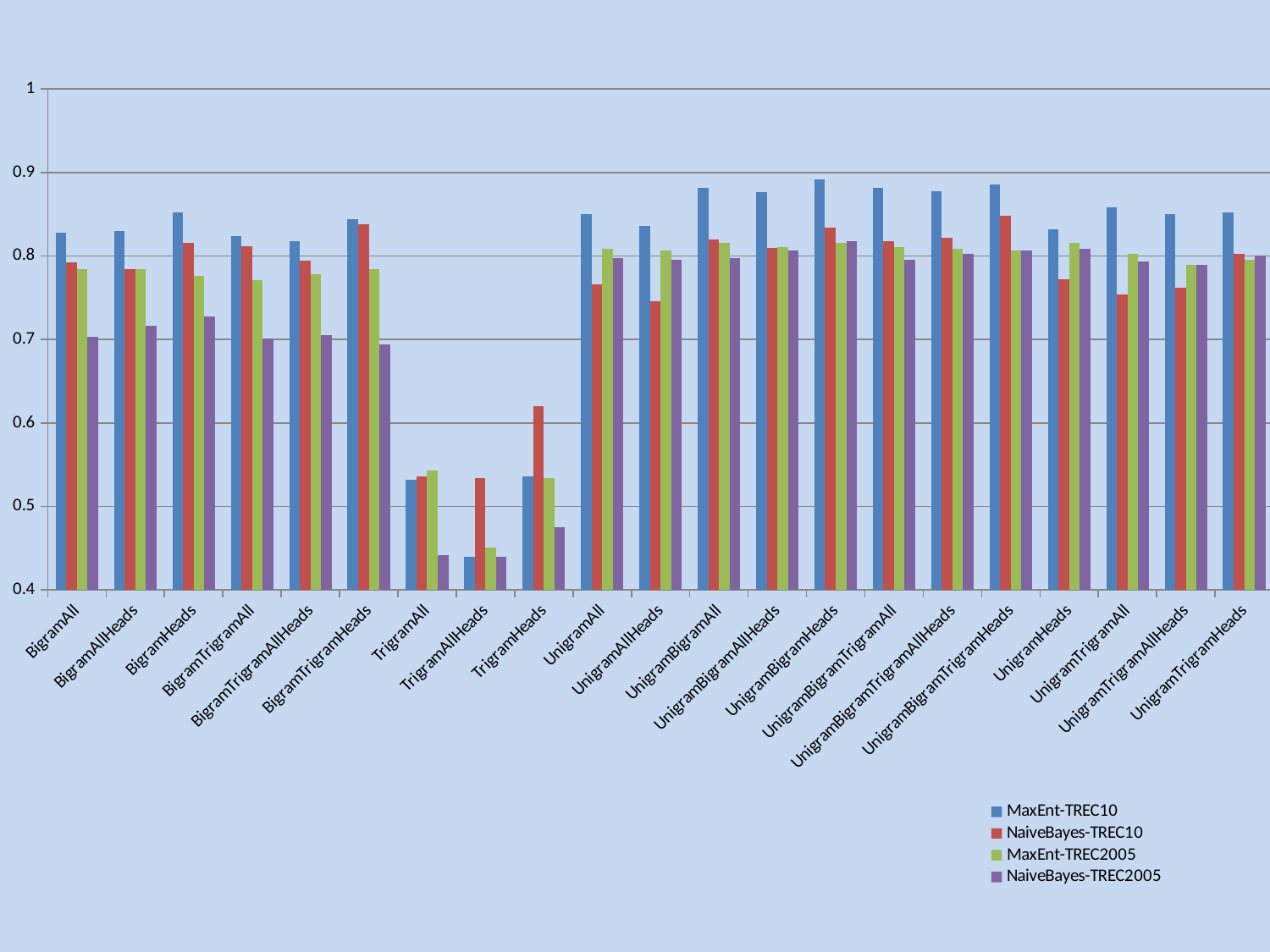
For BigramAll, which is larger: the MaxEnt-TREC10 value or the NaiveBayes-TREC2005 value? MaxEnt-TREC10 Is the NaiveBayes-TREC10 value for TrigramHeads greater or less than 0.6? greater Is the MaxEnt-TREC10 value for UnigramBigramHeads greater or less than 0.8? greater What kind of chart is shown on the slide? bar chart For TrigramHeads, which is larger: the MaxEnt-TREC10 value or the NaiveBayes-TREC10 value? NaiveBayes-TREC10 Which series is shown in blue? MaxEnt-TREC10 Is the MaxEnt-TREC10 value for TrigramAllHeads greater or less than 0.5? less Which category has the lowest MaxEnt-TREC10 value? TrigramAllHeads How many series does the legend list? 4 What is the last entry listed in the legend? NaiveBayes-TREC2005 How many categories are shown along the x axis? 21